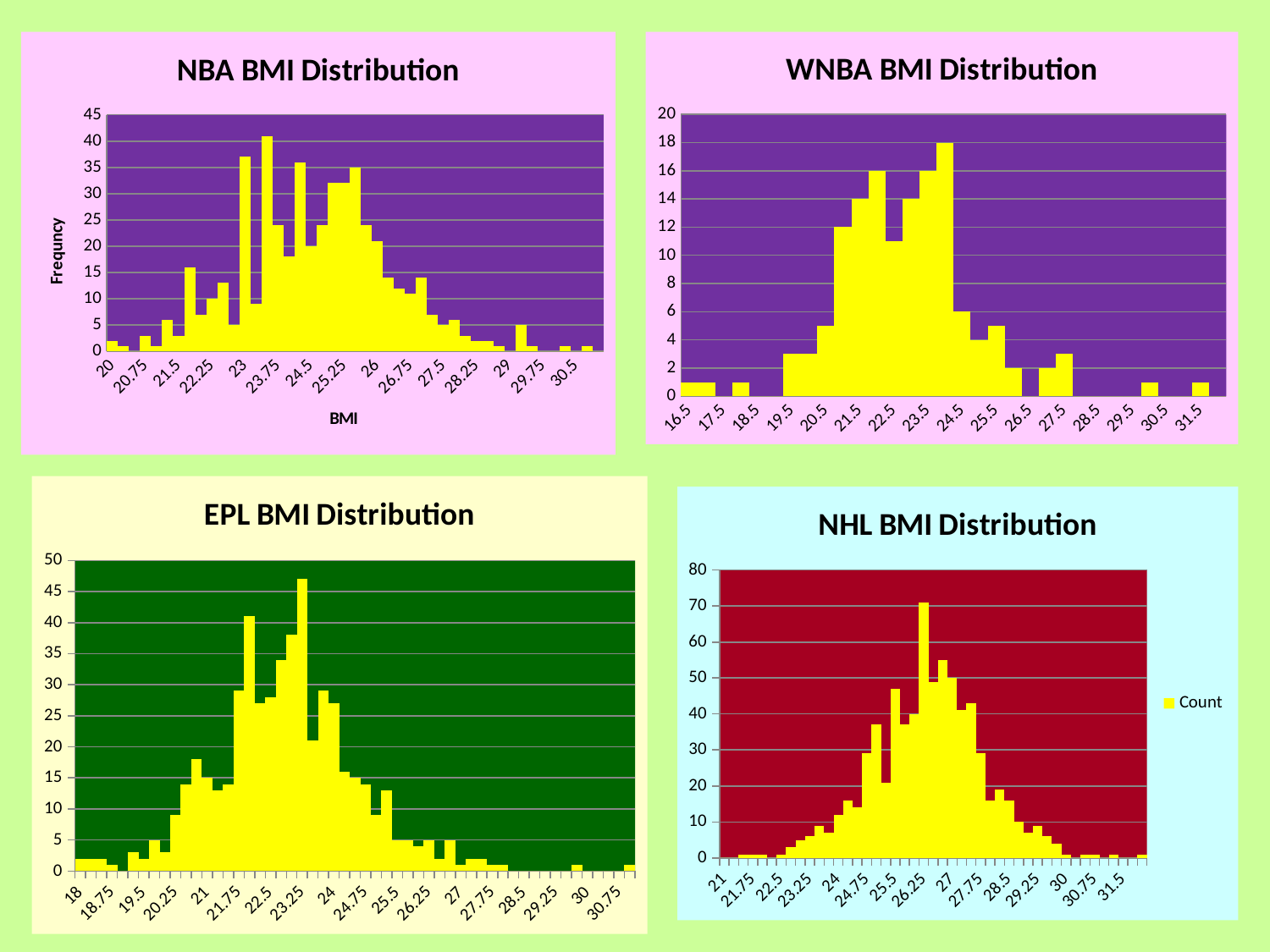
In the WNBA BMI Distribution chart, is the value for BMI 21.5 greater or less than 10? greater In the NBA BMI Distribution chart, is the value for BMI 23 greater or less than 30? greater In the NHL BMI Distribution chart, how many series does the legend list? 1 In the EPL BMI Distribution chart, is the value for BMI 30 greater or less than 5? less In the WNBA BMI Distribution chart, what is the frequency of the tallest bar? 18 In the NHL BMI Distribution chart, what is the legend entry? Count How many charts are shown on the slide? 4 What kind of chart is the NBA BMI Distribution chart? bar chart